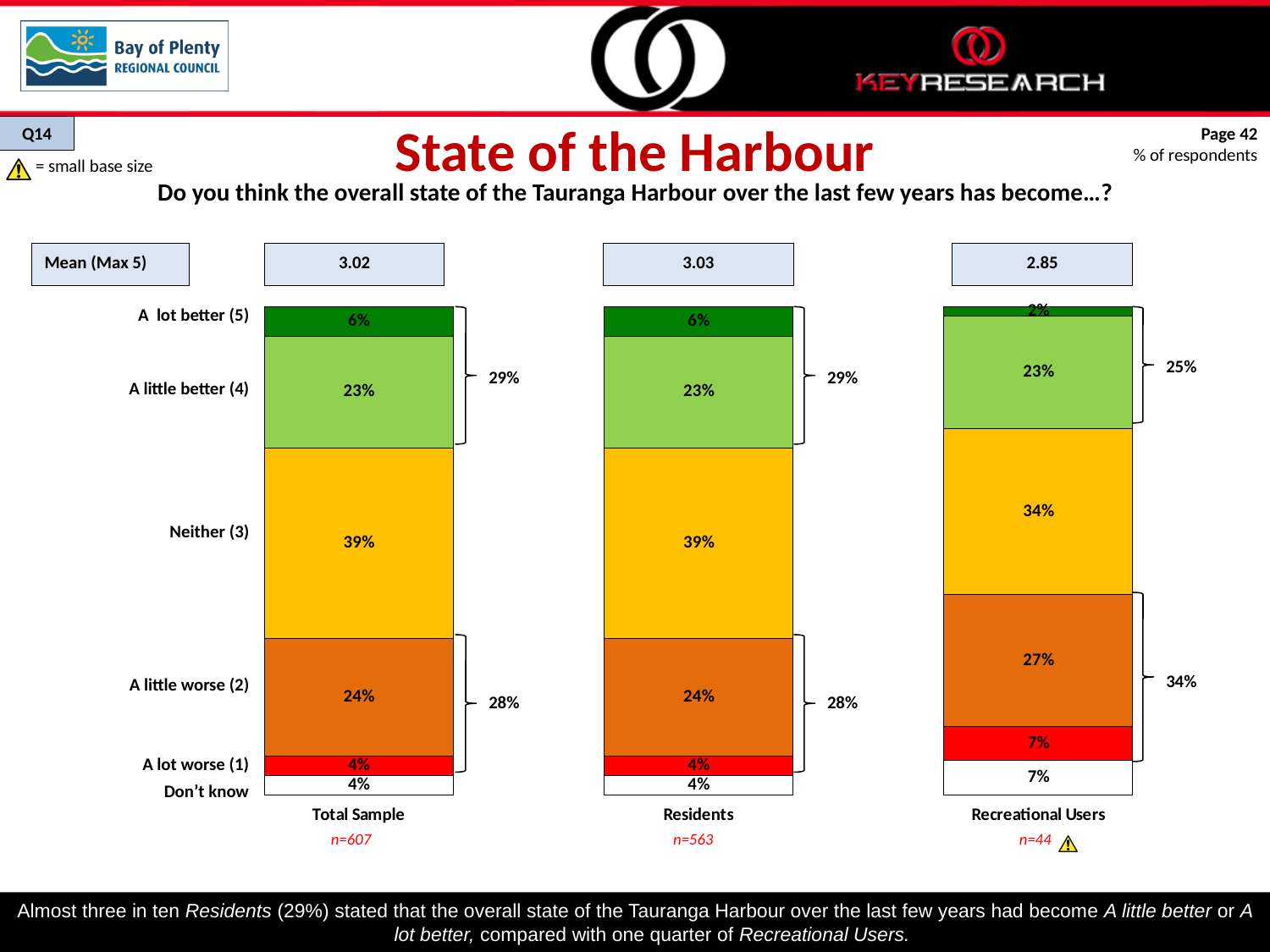
What is the mean score (Max 5) shown for Recreational Users? 2.85 How many response categories are shown in each stacked bar? 6 Which group has a larger 'A lot worse (1)' percentage, Residents or Recreational Users? Recreational Users In the Recreational Users chart, what percentage of respondents said the state of the harbour had become 'Neither (3)'? 34% What is the difference between the 'A little worse (2)' percentage for Recreational Users and for Residents? 3% In the Recreational Users chart, what percentage of respondents answered 'Don't know'? 7% In the Recreational Users chart, which response category has the smallest share of respondents? A lot better (5) What is the combined percentage of 'A lot better (5)' and 'A little better (4)' responses shown for the Total Sample? 29% What type of chart is used to show the responses on this slide? Stacked bar chart In the Total Sample chart, what percentage of respondents answered 'A little worse (2)'? 24% In the Total Sample chart, which response category has the largest share of respondents? Neither (3) In the Residents chart, what percentage of respondents answered 'A lot better (5)'? 6%